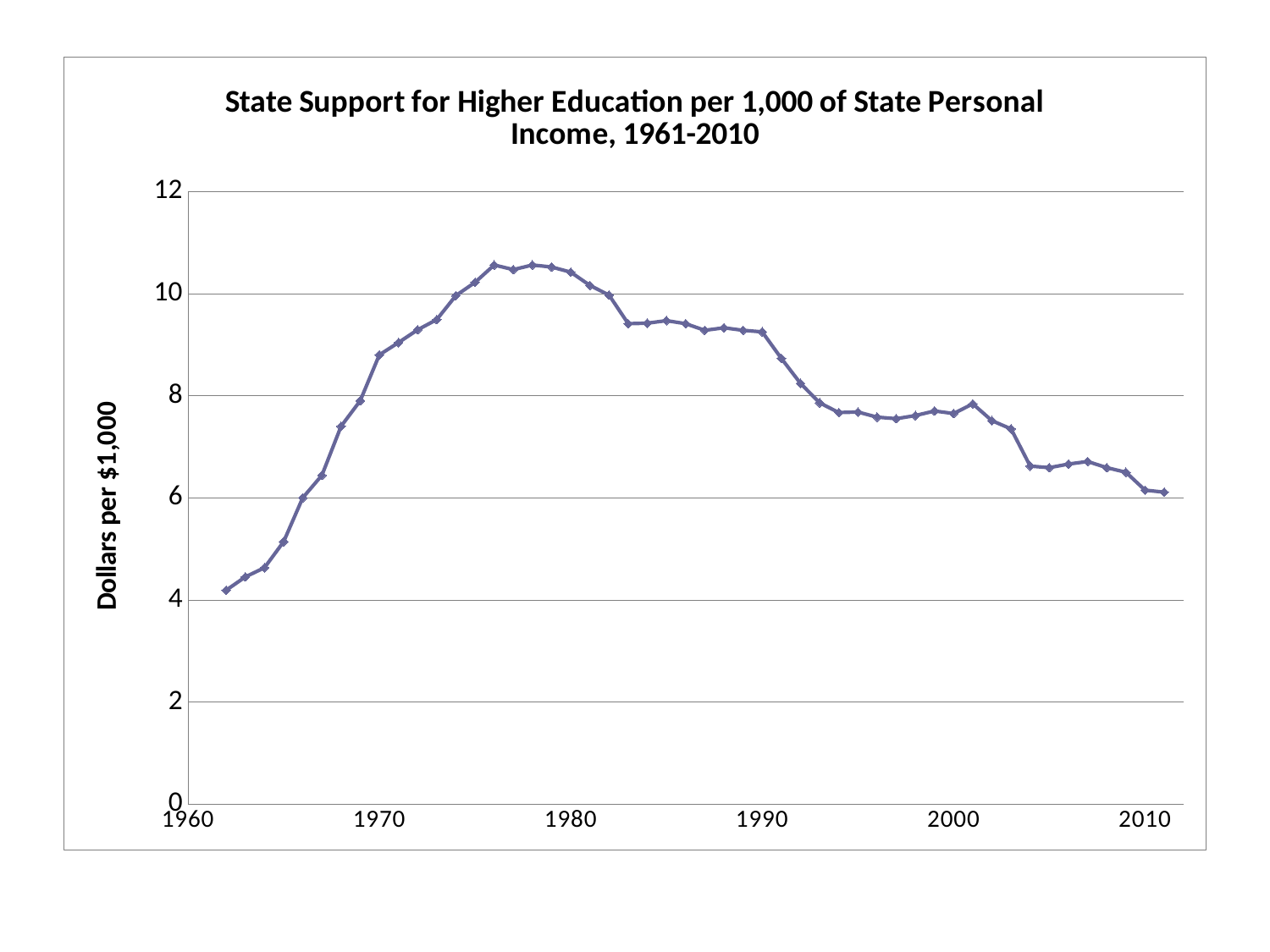
Is the value for 1990 greater or less than 10? less Which year has the larger value, 1970 or 2000? 1970 What is the title of the chart? State Support for Higher Education per 1,000 of State Personal Income, 1961-2010 Is the value for 1970 greater or less than 8? greater Do the values generally rise or fall between 1980 and 2010? fall What kind of chart is shown on the slide? line chart What is the label on the vertical axis? Dollars per $1,000 Which year has the larger value, 1980 or 1990? 1980 Is the value for 2000 greater or less than 8? less Do the values generally rise or fall between 1960 and 1980? rise